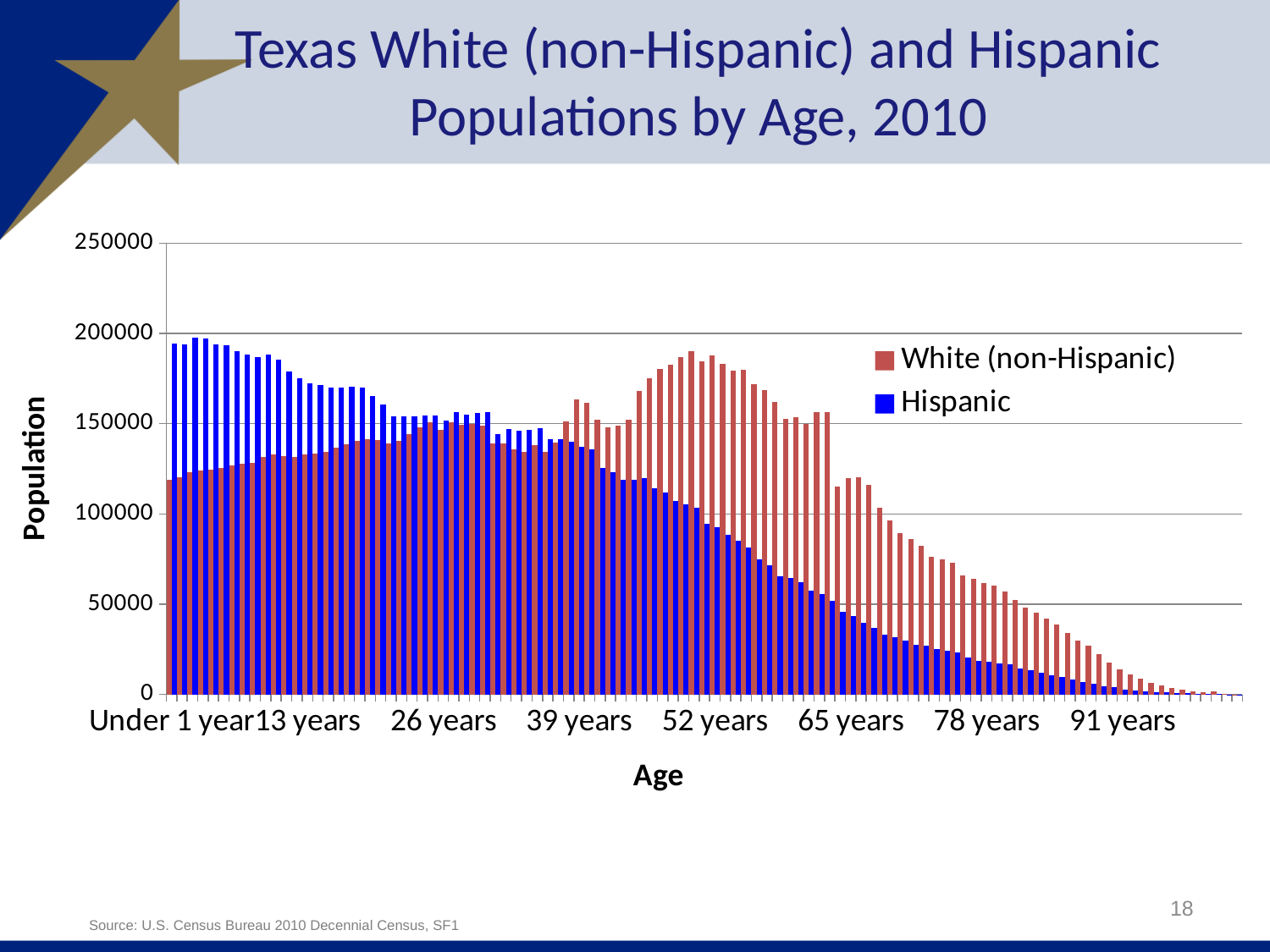
Is the White (non-Hispanic) value for 52 years greater or less than 150000? greater Is the Hispanic value for Under 1 year greater or less than 150000? greater Which two series are listed in the legend? White (non-Hispanic) and Hispanic What is the title of the vertical axis? Population At 52 years, which series has the larger value, White (non-Hispanic) or Hispanic? White (non-Hispanic) How many series does the legend list? 2 Is the White (non-Hispanic) value for 78 years greater or less than 50000? greater What kind of chart is shown on the slide? bar chart At Under 1 year, which series has the larger value, White (non-Hispanic) or Hispanic? Hispanic Do the Hispanic values generally rise or fall as age increases from 26 years to 91 years? fall